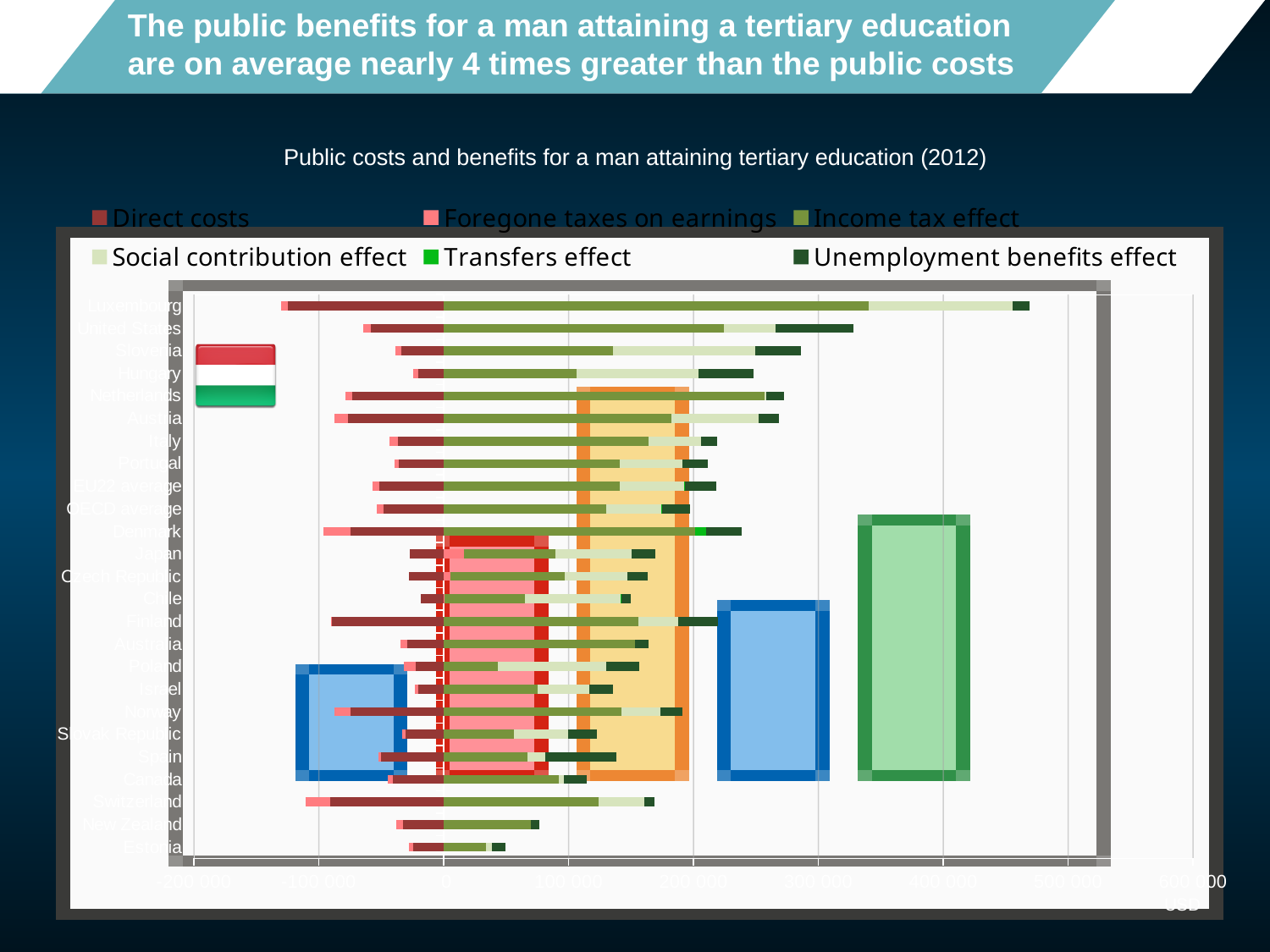
What kind of chart is shown on the slide? bar chart Is the total public benefit for Hungary greater or less than 200 000? greater Do the total public benefits rise or fall going from the top of the chart to the bottom? fall Is the total public benefit for Luxembourg greater or less than 400 000? greater Which legend entry is shown in bright green? Transfers effect Which country has the longest bar of public benefits (extending furthest to the right)? Luxembourg What is the title of the chart? Public costs and benefits for a man attaining tertiary education (2012) Which has the larger total public benefit, Luxembourg or the United States? Luxembourg Which country has the shortest bar of public benefits (extending least to the right)? Estonia Is the total public benefit for the United States greater or less than 300 000? greater How many series does the legend list? 6